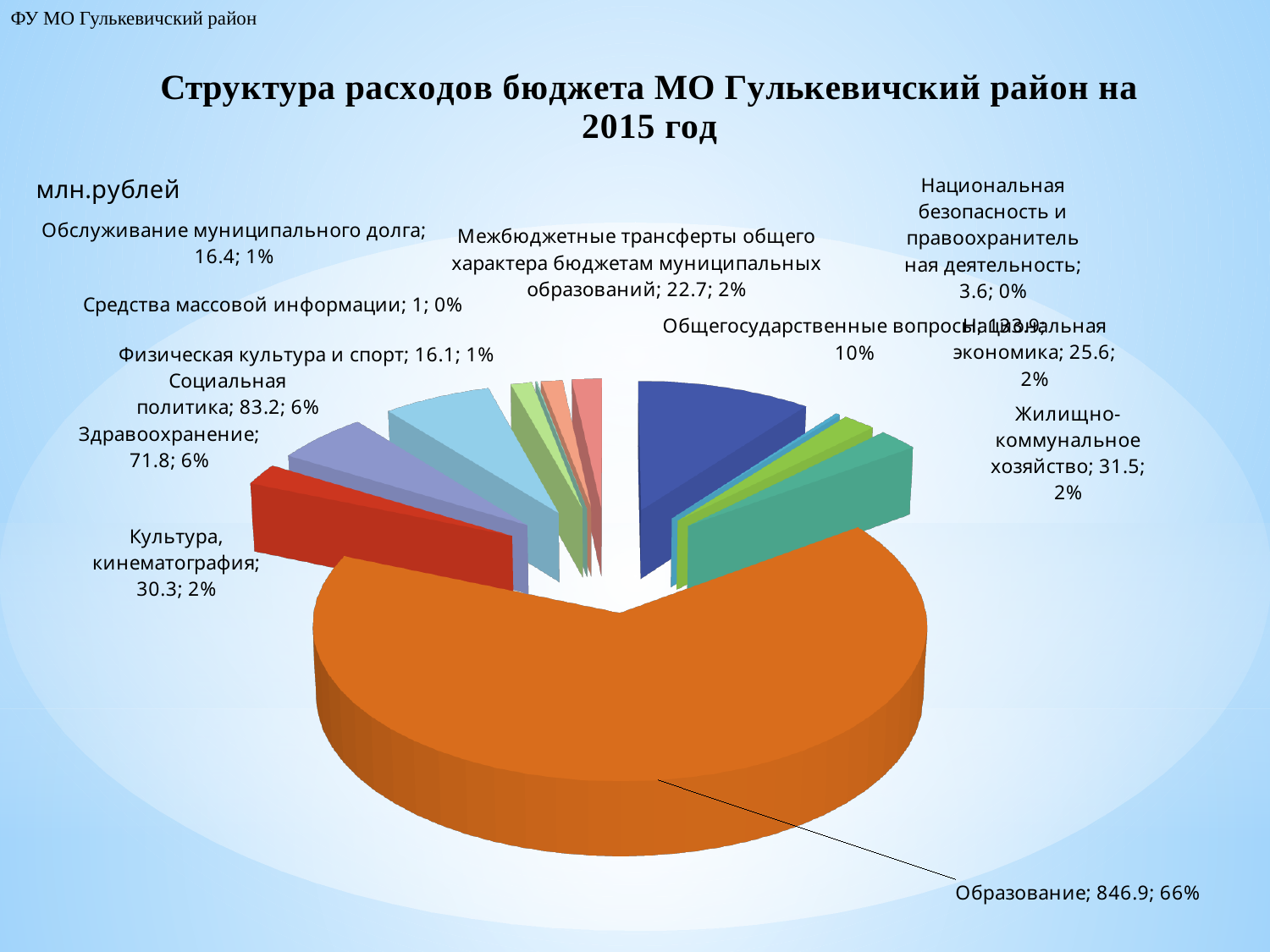
What is the difference between the values for Социальная политика and Здравоохранение? 11.4 Which category has the smallest value? Средства массовой информации What is the value for Социальная политика? 83.2 What is the value for Жилищно-коммунальное хозяйство? 31.5 What share of the pie does Образование account for? 66% Which is larger: Культура, кинематография or Национальная экономика? Культура, кинематография How many categories are shown in the pie chart? 12 What kind of chart is shown on the slide? pie chart In what units are the values on the chart given? млн.рублей Which category has the largest share of the budget expenditures? Образование What is the value for Образование? 846.9 What is the value for Здравоохранение? 71.8